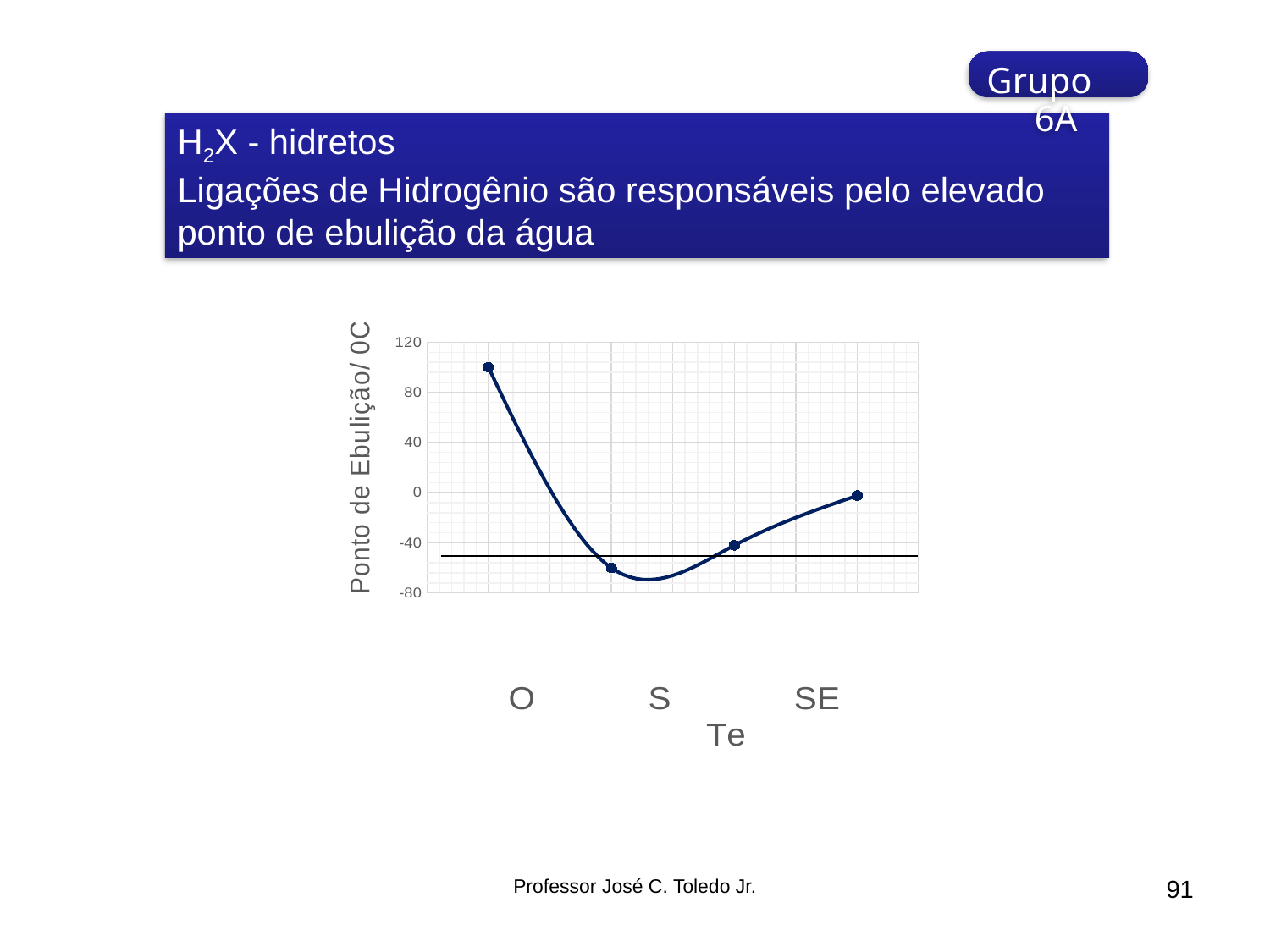
Which has the larger boiling point, O or S? O What kind of chart is shown on the slide? line chart Which category has the highest boiling point on the chart? O Is the value for S greater or less than -40? less Does the line rise or fall from the first point (O) to the second point (S)? fall Which category has the lowest boiling point on the chart? S Is the value for O greater or less than 120? less Is the value for S greater or less than -80? greater How many data points are plotted on the line? 4 What is the title of the vertical axis? Ponto de Ebulição/ 0C